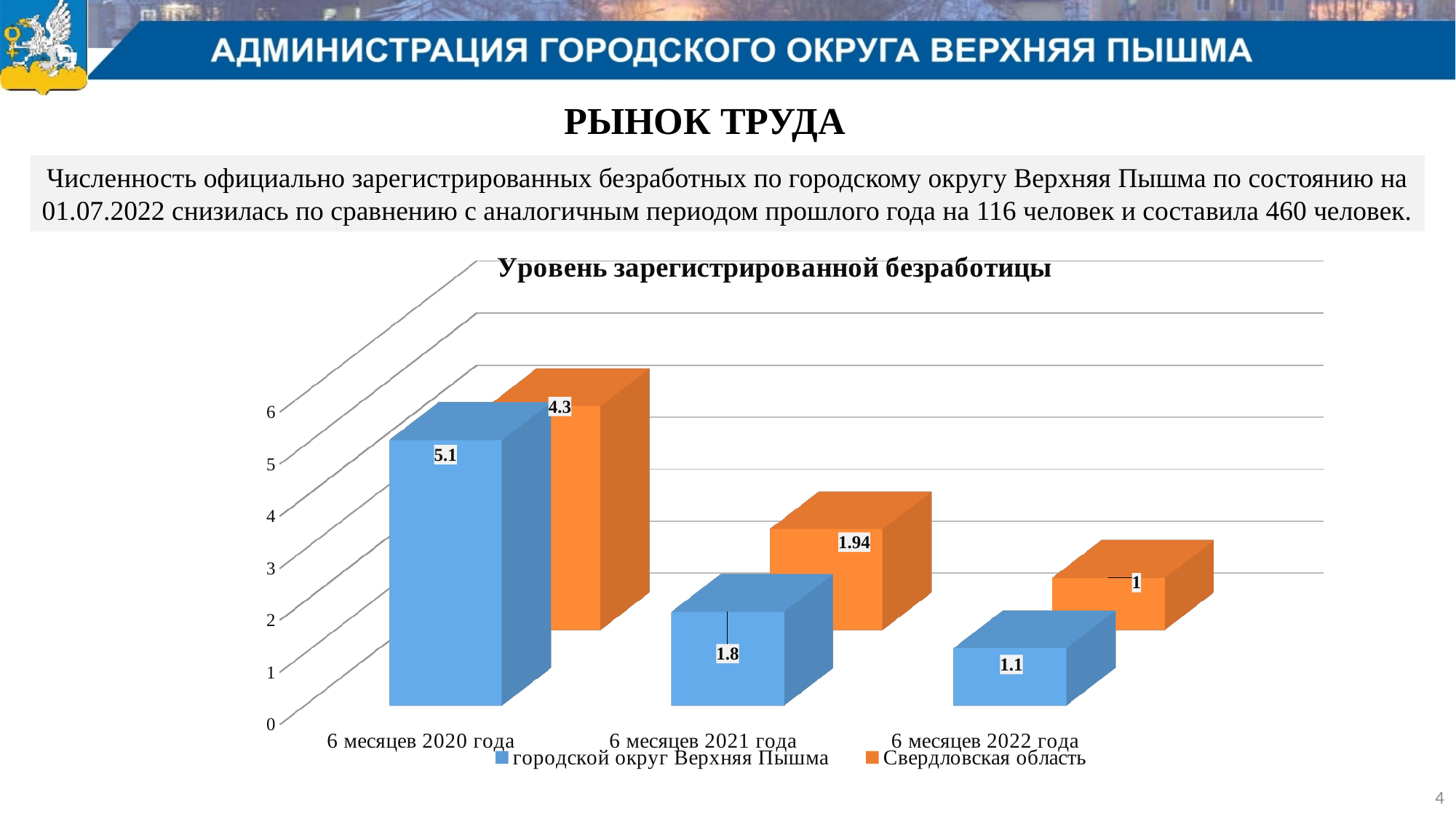
Каково значение для городского округа Верхняя Пышма за 6 месяцев 2022 года? 1.1 В каком периоде значение для городского округа Верхняя Пышма наибольшее? 6 месяцев 2020 года Каково значение для Свердловской области за 6 месяцев 2022 года? 1 Каково значение для городского округа Верхняя Пышма за 6 месяцев 2020 года на диаграмме «Уровень зарегистрированной безработицы»? 5.1 Сколько периодов (категорий) показано на диаграмме? 3 Сколько рядов данных указано в легенде диаграммы? 2 Что больше за 6 месяцев 2020 года: значение для городского округа Верхняя Пышма или для Свердловской области? городской округ Верхняя Пышма В каком периоде значение для Свердловской области наименьшее? 6 месяцев 2022 года На сколько значение для городского округа Верхняя Пышма за 6 месяцев 2020 года больше, чем за 6 месяцев 2021 года? 3.3 Как меняются значения для городского округа Верхняя Пышма от 2020 к 2022 году — растут или снижаются? снижаются Каково значение для Свердловской области за 6 месяцев 2021 года? 1.94 Какого типа эта диаграмма? столбчатая (bar chart)